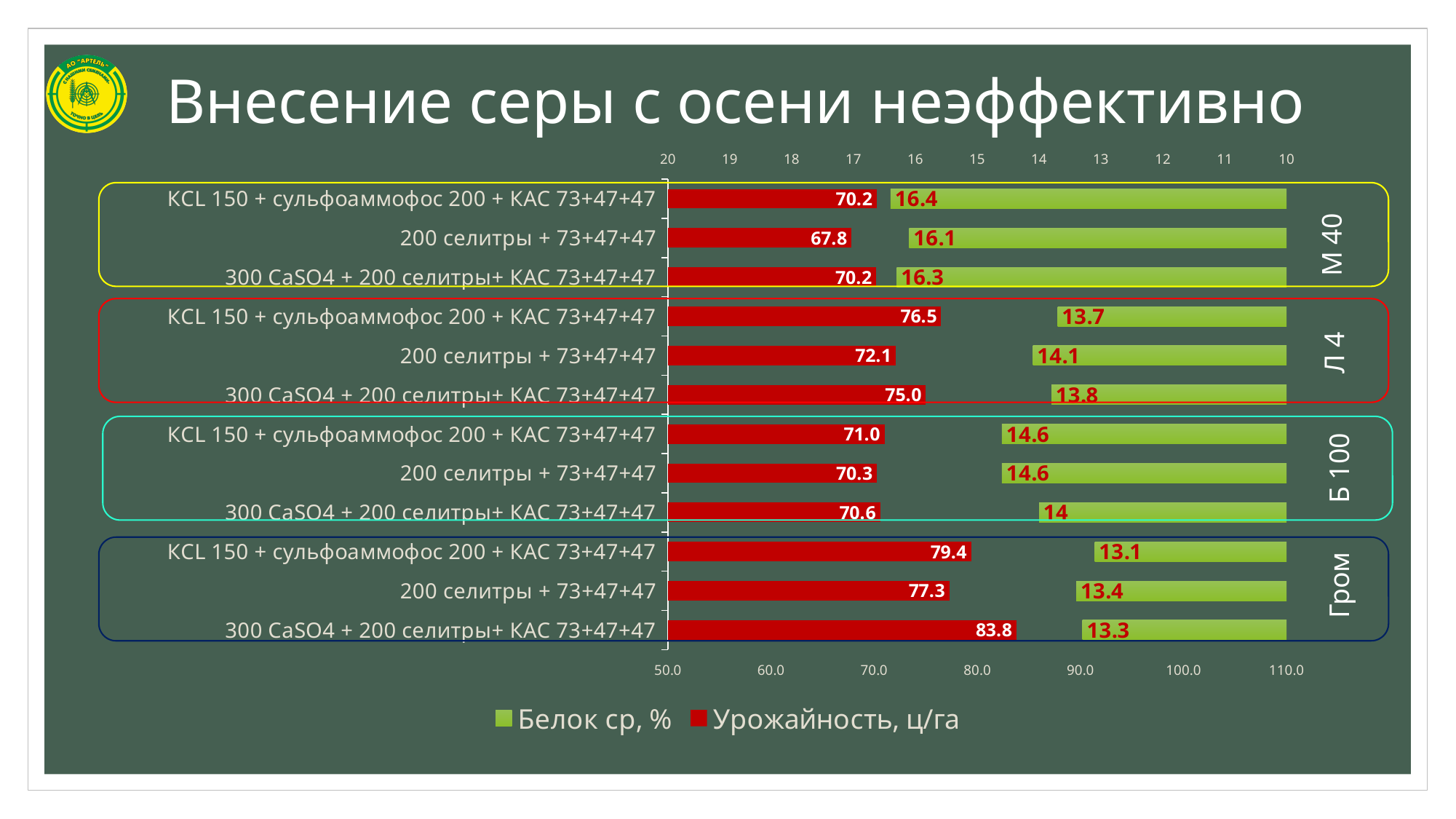
Which group and treatment has the lowest Белок ср, % value? Гром, KCL 150 + сульфоаммофос 200 + КАС 73+47+47 How many treatment bars are plotted for the Урожайность, ц/га series in total? 12 What is the Белок ср, % value for '300 CaSO4 + 200 селитры+ КАС 73+47+47' in the Б 100 group? 14 What type of chart is shown on the slide? bar chart What is the Белок ср, % value for 'KCL 150 + сульфоаммофос 200 + КАС 73+47+47' in the М 40 group? 16.4 How many series does the legend list? 2 What is the Урожайность, ц/га value for '300 CaSO4 + 200 селитры+ КАС 73+47+47' in the Гром group? 83.8 In the Л 4 group, which treatment has the larger Урожайность, ц/га: 'KCL 150 + сульфоаммофос 200 + КАС 73+47+47' or '300 CaSO4 + 200 селитры+ КАС 73+47+47'? KCL 150 + сульфоаммофос 200 + КАС 73+47+47 What is the Урожайность, ц/га value for '200 селитры + 73+47+47' in the Л 4 group? 72.1 What is the difference in Урожайность, ц/га between '300 CaSO4 + 200 селитры+ КАС 73+47+47' and '200 селитры + 73+47+47' in the Гром group? 6.5 Which group and treatment has the lowest Урожайность, ц/га value? М 40, 200 селитры + 73+47+47 Which group and treatment has the highest Урожайность, ц/га value? Гром, 300 CaSO4 + 200 селитры+ КАС 73+47+47